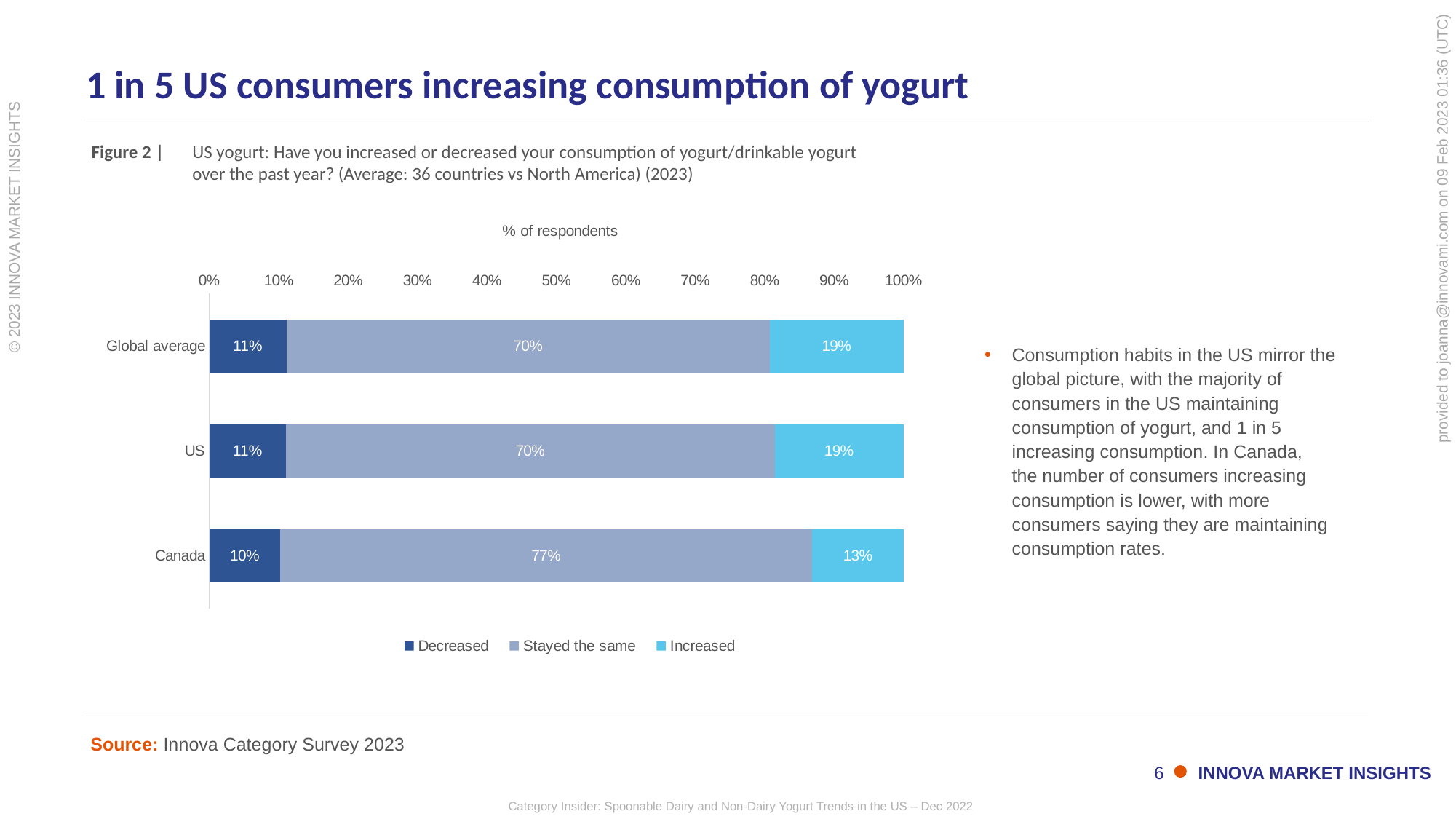
What is the axis title shown above the chart? % of respondents What percentage of Canada respondents said their yogurt consumption stayed the same? 77% What is the total of the stacked bar for Canada? 100% How many series does the legend list? 3 Which category has the highest value for Stayed the same? Canada Which category has the lowest value for Increased? Canada What is the difference between the Increased values for the US and Canada? 6% How many categories are shown on the chart? 3 What kind of chart is shown on the slide? Stacked bar chart What percentage of US respondents said their yogurt consumption increased? 19% Which is larger: the Stayed the same value for Canada or for the US? Canada What is the value for Decreased for the Global average? 11%